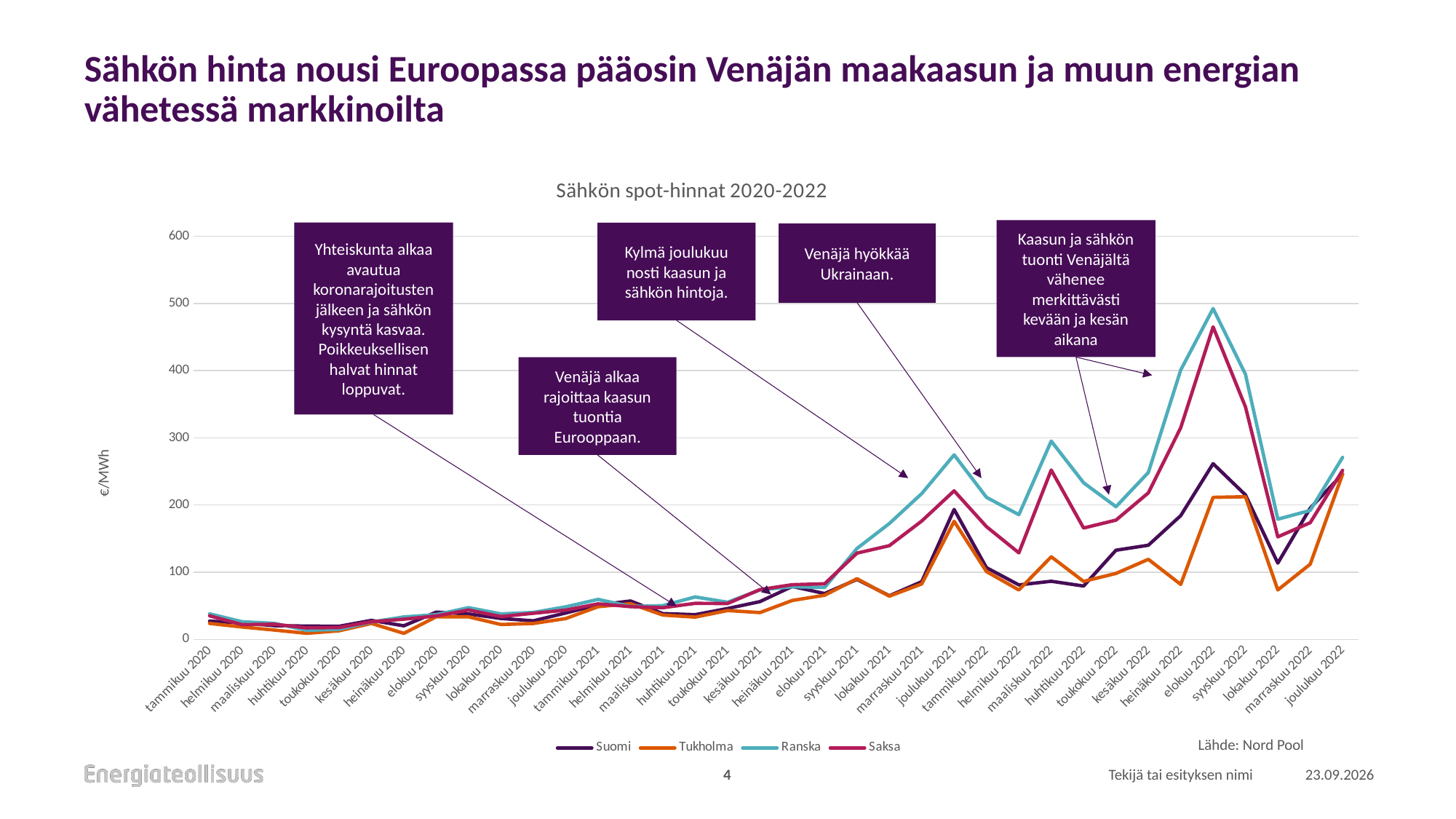
In elokuu 2022, which is larger, the value for Saksa or the value for Tukholma? Saksa Is the value for Ranska in elokuu 2022 greater or less than 400? greater What unit is shown on the y axis label? €/MWh What is the title of the chart? Sähkön spot-hinnat 2020-2022 Do the values for Ranska rise or fall from tammikuu 2020 to elokuu 2022? rise Is the value for Suomi in elokuu 2022 greater or less than 300? less Which series has the lowest value in maaliskuu 2022? Suomi Which series has the highest value in elokuu 2022? Ranska Is the value for Tukholma in lokakuu 2022 greater or less than 100? less How many series does the legend list? 4 What kind of chart is shown on the slide? line chart How many monthly points are plotted along the x axis? 36